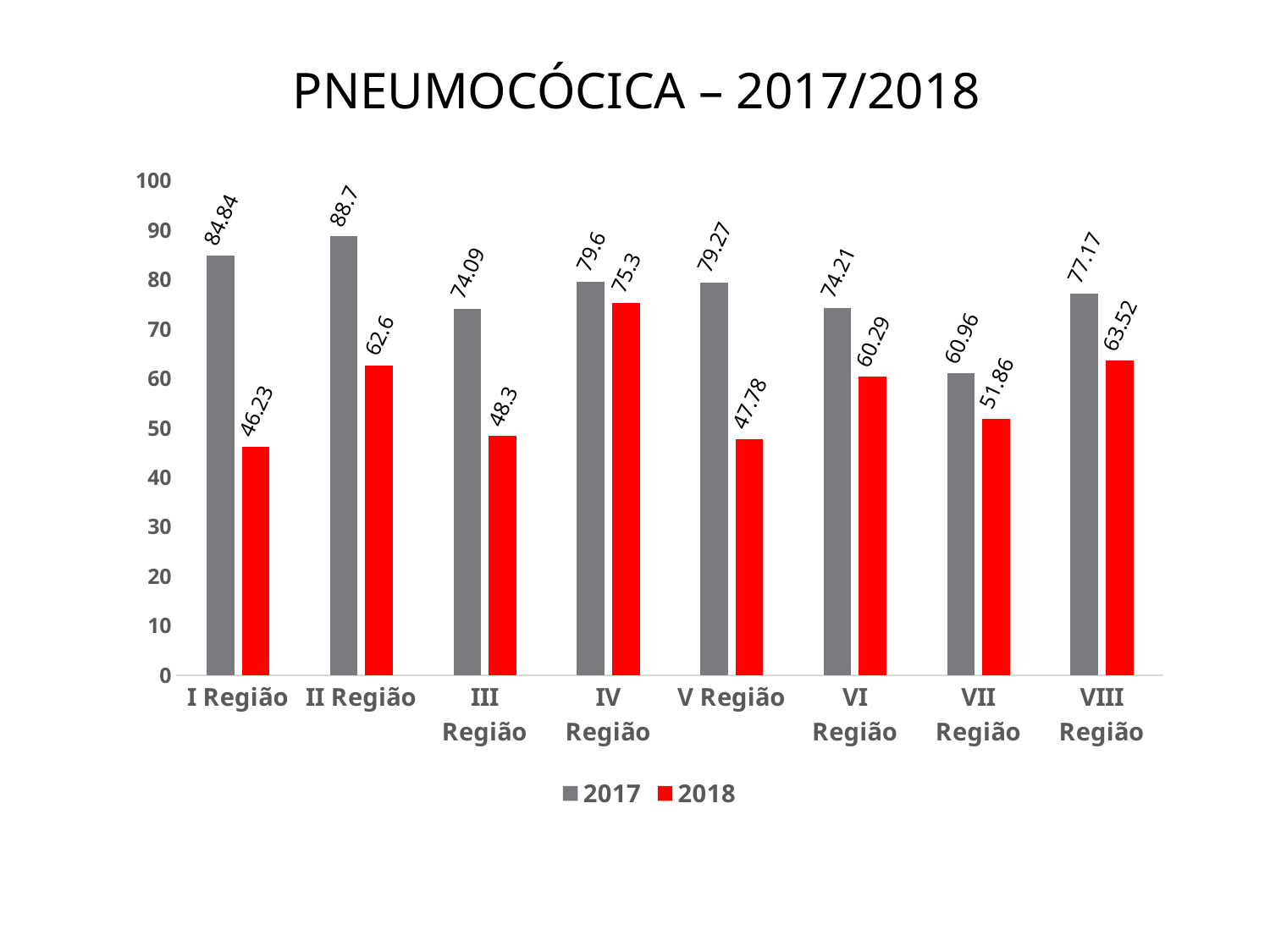
What is the 2017 value for II Região? 88.7 Which region has the lowest 2017 value? VII Região Which is larger for IV Região, the 2017 value or the 2018 value? 2017 What is the 2018 value for V Região? 47.78 How many regions are shown on the x axis? 8 Which region has the highest 2017 value? II Região What colour represents the 2018 series? Red What is the difference between the 2017 and 2018 values for I Região? 38.61 What is the 2018 value for VIII Região? 63.52 How many series does the legend list? 2 Which region has the lowest 2018 value? I Região What kind of chart is shown on the slide? Bar chart